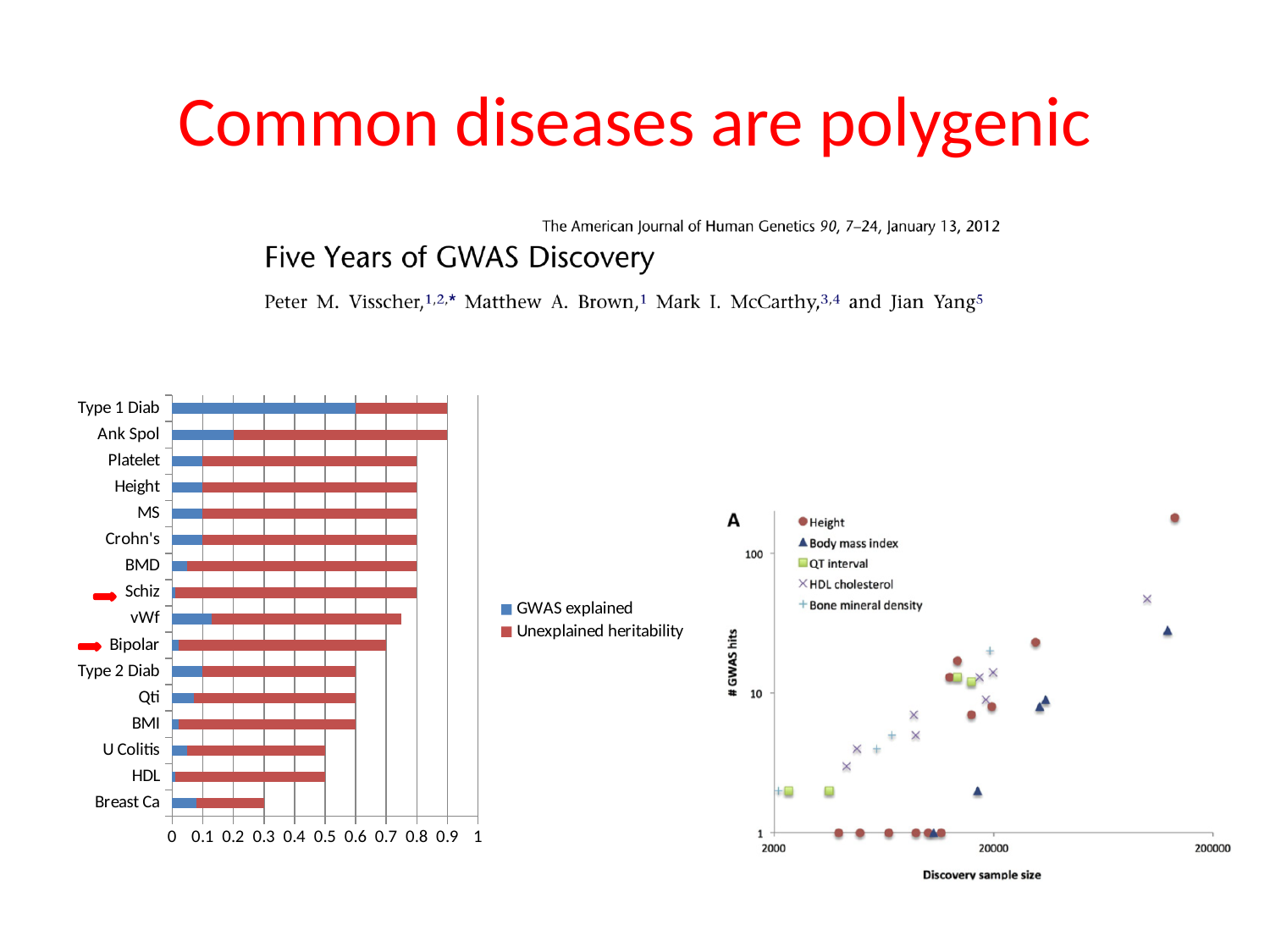
On the left bar chart, which category has the largest GWAS explained portion? Type 1 Diab What kind of chart is the chart on the left of the slide? bar chart On the left bar chart, which category has the shortest total bar? Breast Ca On the left bar chart, is the total bar for HDL greater or less than 0.6? less On the left bar chart, which has the longer total bar, Type 2 Diab or Breast Ca? Type 2 Diab On the left bar chart, is the total bar for Bipolar greater or less than 0.6? greater What kind of chart is the chart on the right of the slide? scatter chart On the left bar chart, what is the GWAS explained value for Type 1 Diab? 0.6 How many categories are shown on the left bar chart? 16 On the left bar chart, what is the total bar length for Type 1 Diab? 0.9 How many series does the legend of the left bar chart list? 2 How many series does the legend of the right scatter chart list? 5